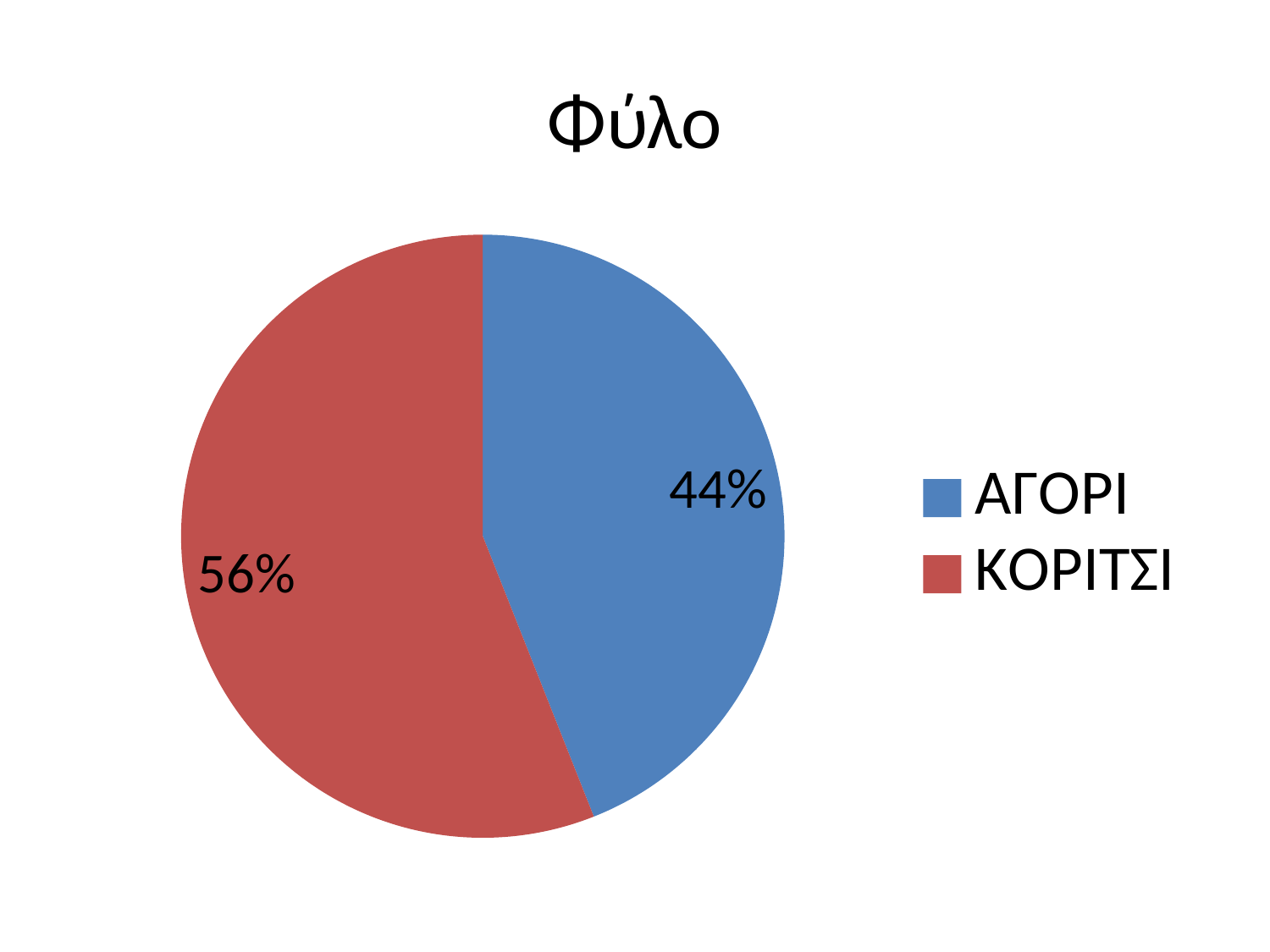
Which is larger, the share for ΑΓΟΡΙ or the share for ΚΟΡΙΤΣΙ? ΚΟΡΙΤΣΙ What share of the pie does ΑΓΟΡΙ represent? 44% What colour is the slice for ΑΓΟΡΙ? blue What is the difference in percentage points between ΚΟΡΙΤΣΙ and ΑΓΟΡΙ? 12% What is the title of the chart? Φύλο Which category has the smallest slice of the pie? ΑΓΟΡΙ How many entries does the legend list? 2 What kind of chart is shown on the slide? pie chart Is the share for ΚΟΡΙΤΣΙ greater or less than 50%? greater How many categories does the pie chart have? 2 Which category has the largest slice of the pie? ΚΟΡΙΤΣΙ What share of the pie does ΚΟΡΙΤΣΙ represent? 56%